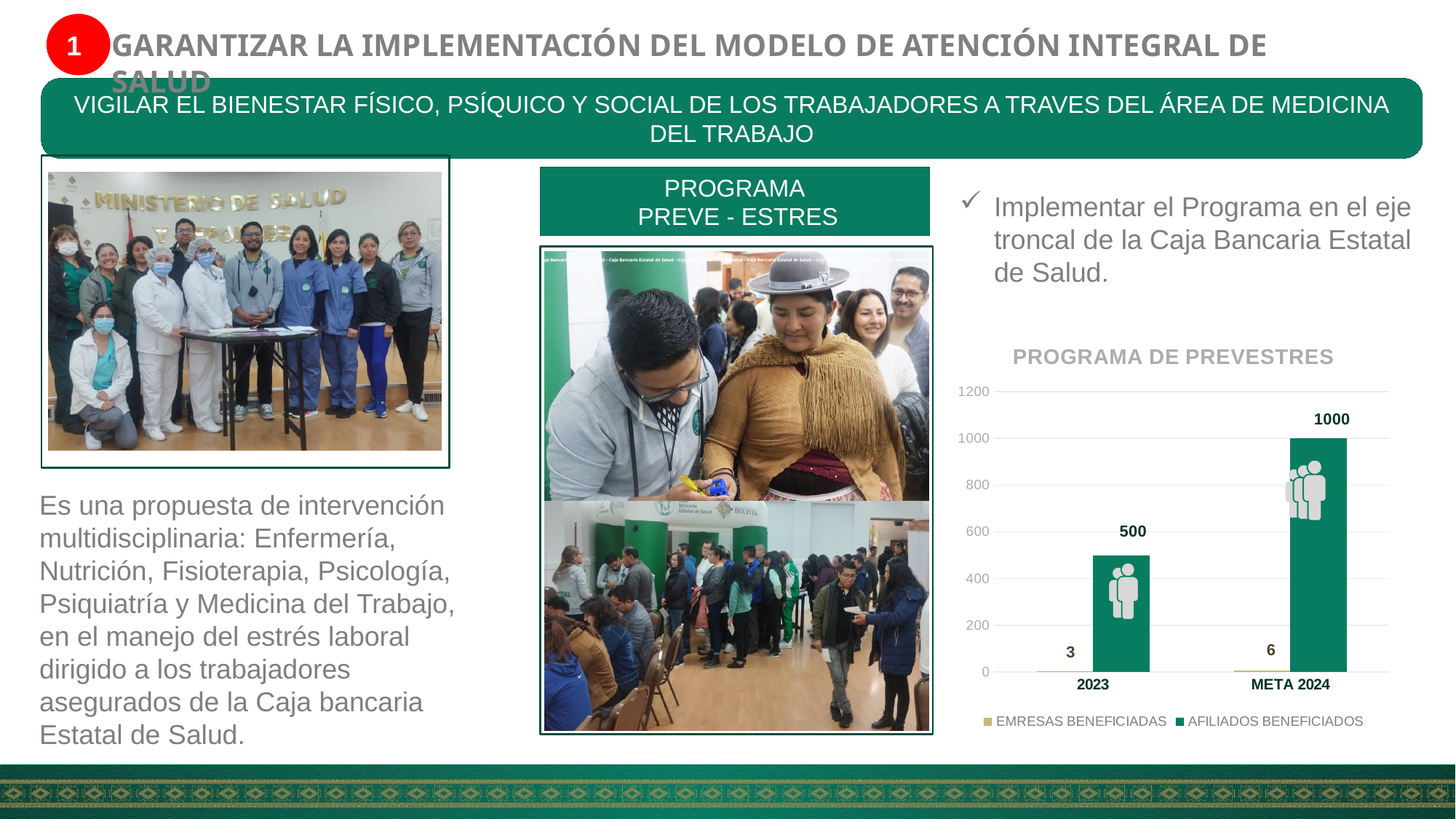
Do the values for AFILIADOS BENEFICIADOS rise or fall from 2023 to META 2024? rise Which category has the higher value for AFILIADOS BENEFICIADOS, 2023 or META 2024? META 2024 Which series is shown in green in the chart? AFILIADOS BENEFICIADOS What is the title of the chart on the slide? PROGRAMA DE PREVESTRES How many series does the chart legend list? 2 What type of chart is shown on the slide? bar chart What is the value of AFILIADOS BENEFICIADOS for META 2024? 1000 How many categories are shown on the x axis of the chart? 2 What is the value of EMRESAS BENEFICIADAS for 2023? 3 What is the value of EMRESAS BENEFICIADAS for META 2024? 6 What is the difference between AFILIADOS BENEFICIADOS for META 2024 and 2023? 500 What is the value of AFILIADOS BENEFICIADOS for 2023? 500